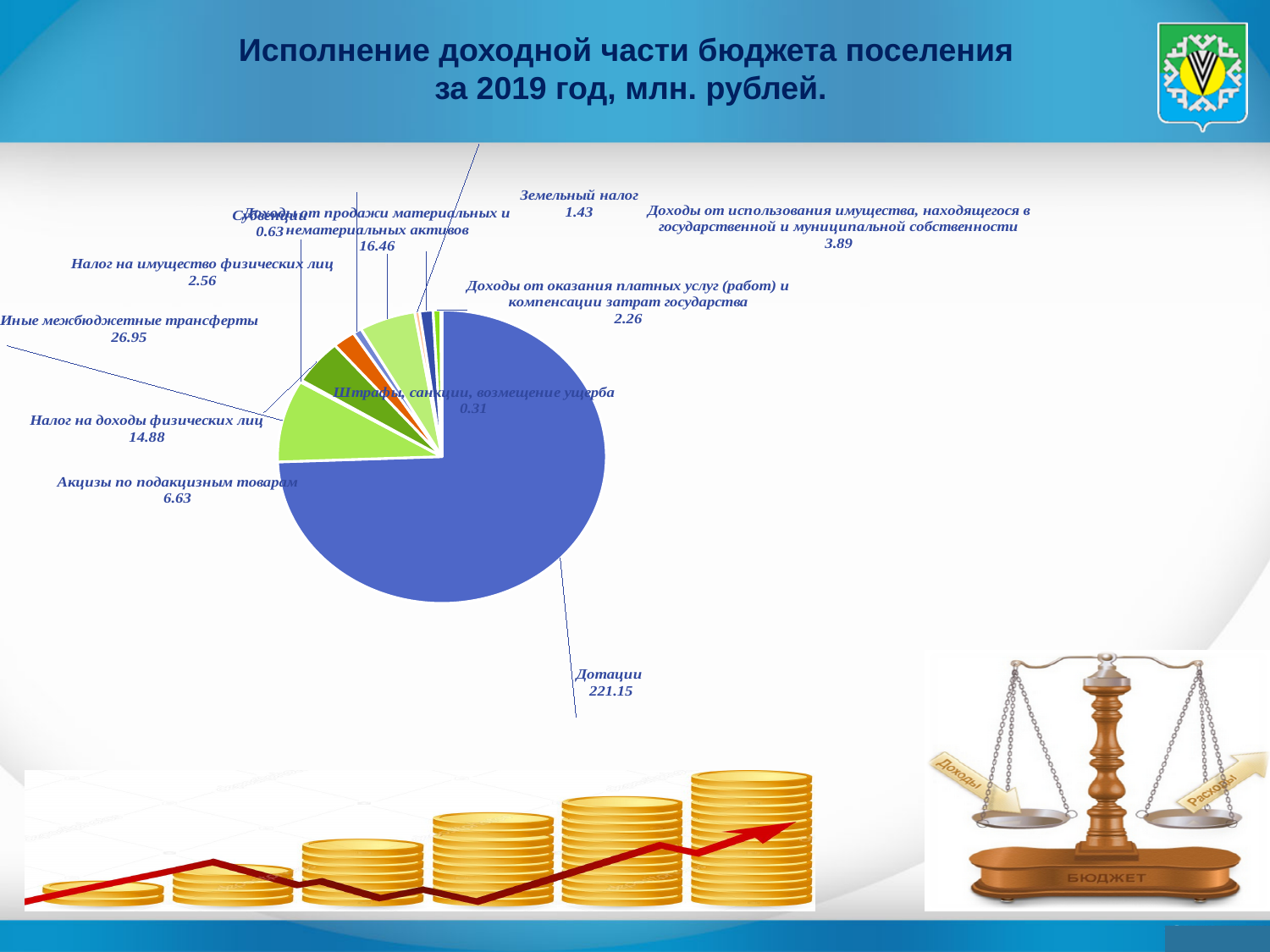
What is the value for Дотации? 221.15 What is the title of the slide containing the chart? Исполнение доходной части бюджета поселения за 2019 год, млн. рублей. What is the value for Акцизы по подакцизным товарам? 6.63 How many categories are shown in the pie chart? 11 What type of chart is shown on the slide? pie chart Which category has the smallest value in the pie chart? Штрафы, санкции, возмещение ущерба Which is larger: Налог на имущество физических лиц or Доходы от использования имущества, находящегося в государственной и муниципальной собственности? Доходы от использования имущества, находящегося в государственной и муниципальной собственности What is the value for Земельный налог? 1.43 Which category has the largest value in the pie chart? Дотации What is the value for Налог на доходы физических лиц? 14.88 What is the value for Иные межбюджетные трансферты? 26.95 What is the difference between Иные межбюджетные трансферты and Доходы от продажи материальных и нематериальных активов? 10.49